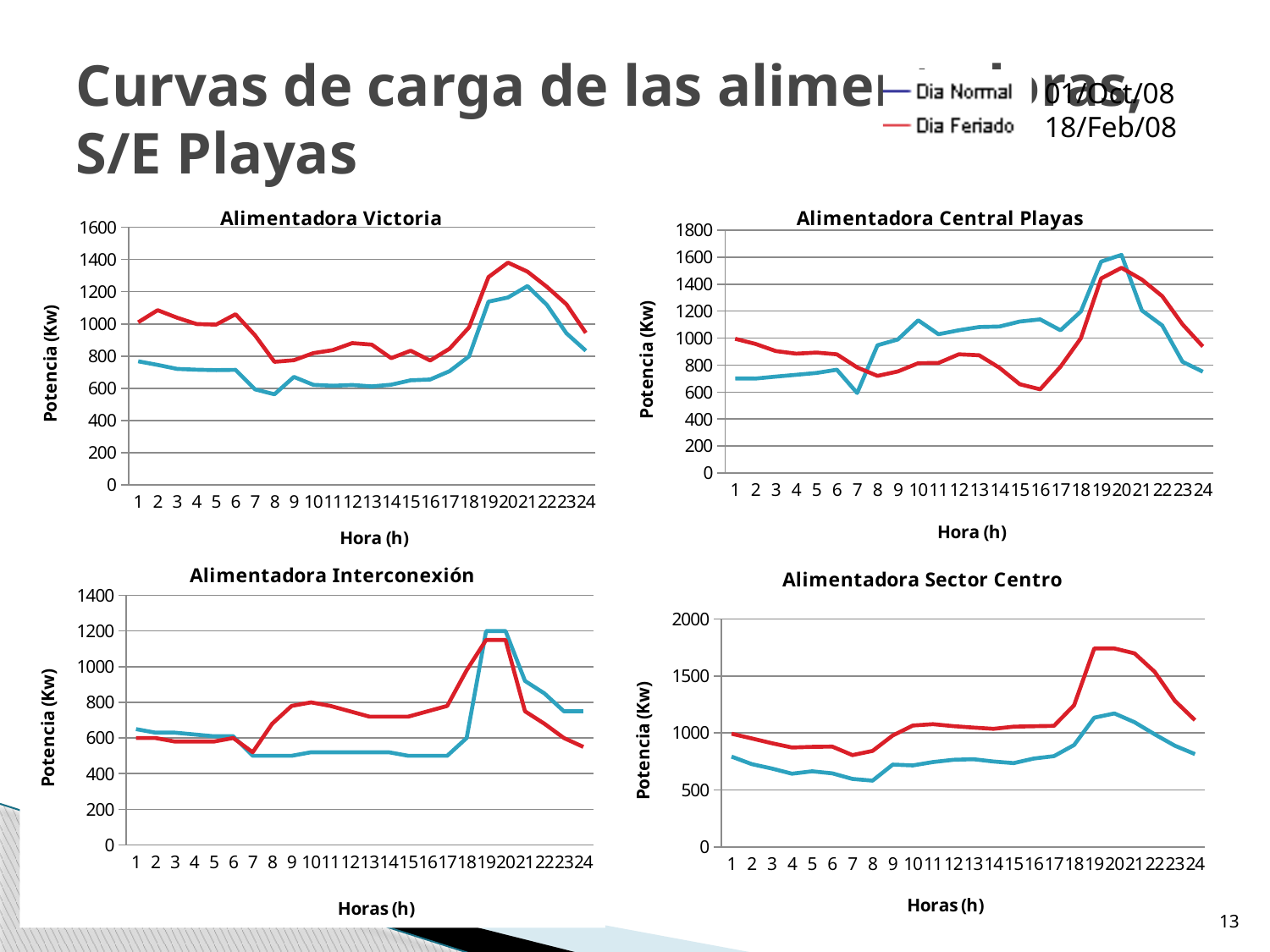
In the Alimentadora Sector Centro chart, does the Dia Feriado (red) line rise or fall from hour 20 to hour 24? fall What kind of chart is the Alimentadora Victoria chart? line chart How many hours (points) are plotted along the x axis of the Alimentadora Central Playas chart? 24 In the Alimentadora Victoria chart, is the Dia Normal (blue) value at hour 8 greater or less than 600? less In the Alimentadora Central Playas chart, is the Dia Feriado (red) value at hour 16 greater or less than 800? less In the Alimentadora Central Playas chart, is the Dia Normal (blue) value at hour 20 greater or less than 1400? greater What is the y-axis label on the Alimentadora Interconexión chart? Potencia (Kw) In the Alimentadora Interconexión chart, which series has the higher value at hour 10, Dia Normal or Dia Feriado? Dia Feriado In the Alimentadora Victoria chart, at which hour does the Dia Feriado (red) line reach its highest value? 20 How many series does the legend at the top of the slide list? 2